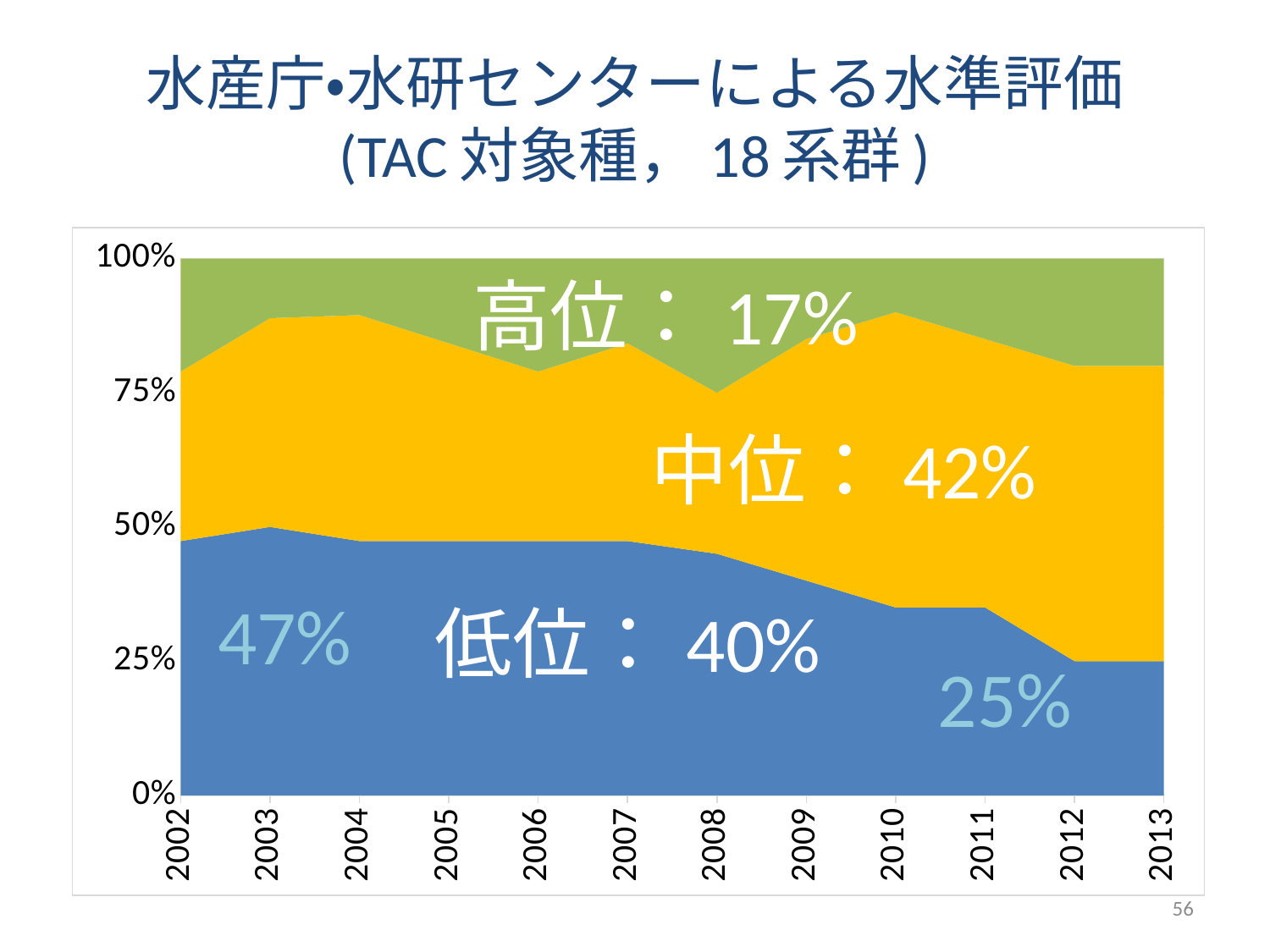
What kind of chart is shown on the slide? area chart What percentage is printed next to the label 高位? 17% How many years are shown along the x axis? 12 How many stacked series (低位, 中位, 高位) does the chart show? 3 Is the share of 低位 in 2003 greater or less than 25%? greater What is the share of 低位 in 2002, as labelled on the chart? 47% What percentage is printed next to the label 低位? 40% Which is larger, the share of 低位 in 2002 or in 2013? 2002 Does the share of 低位 rise or fall from 2002 to 2013? fall What percentage is printed next to the label 中位? 42% What is the share of 低位 in 2013, as labelled on the chart? 25% By how many percentage points does the labelled share of 低位 in 2002 exceed that in 2013? 22